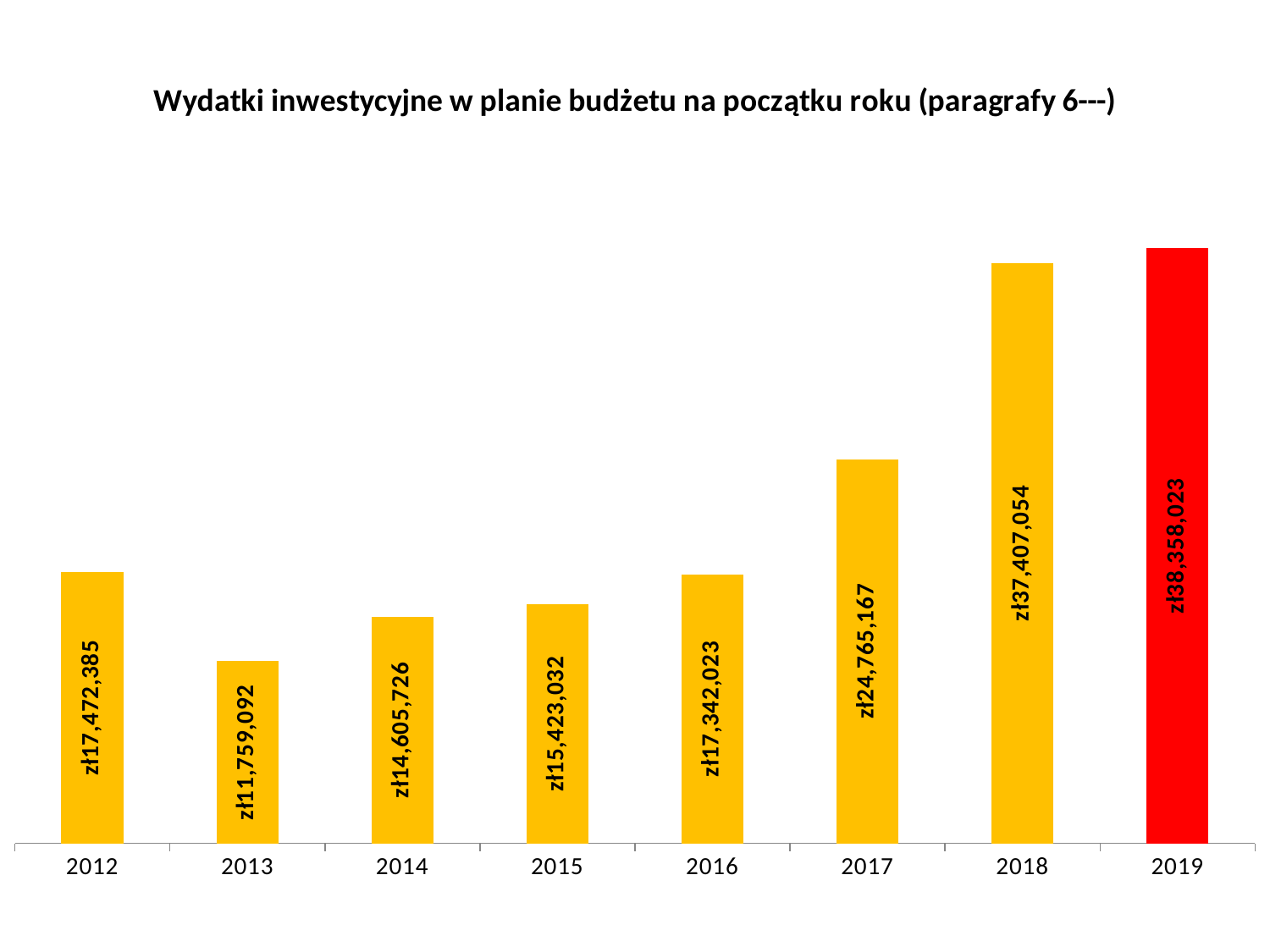
How many years are shown on the x axis? 8 What is the value for 2013? zł11,759,092 Which year's bar is coloured red instead of yellow? 2019 Which year has the highest value? 2019 What is the value for 2017? zł24,765,167 What is the difference between the values for 2019 and 2018? zł950,969 What is the value for 2019? zł38,358,023 Do the values rise or fall from 2013 to 2019? rise What is the difference between the values for 2012 and 2013? zł5,713,293 Which is larger, the value for 2017 or the value for 2015? 2017 Which year has the lowest value? 2013 What kind of chart is this? bar chart